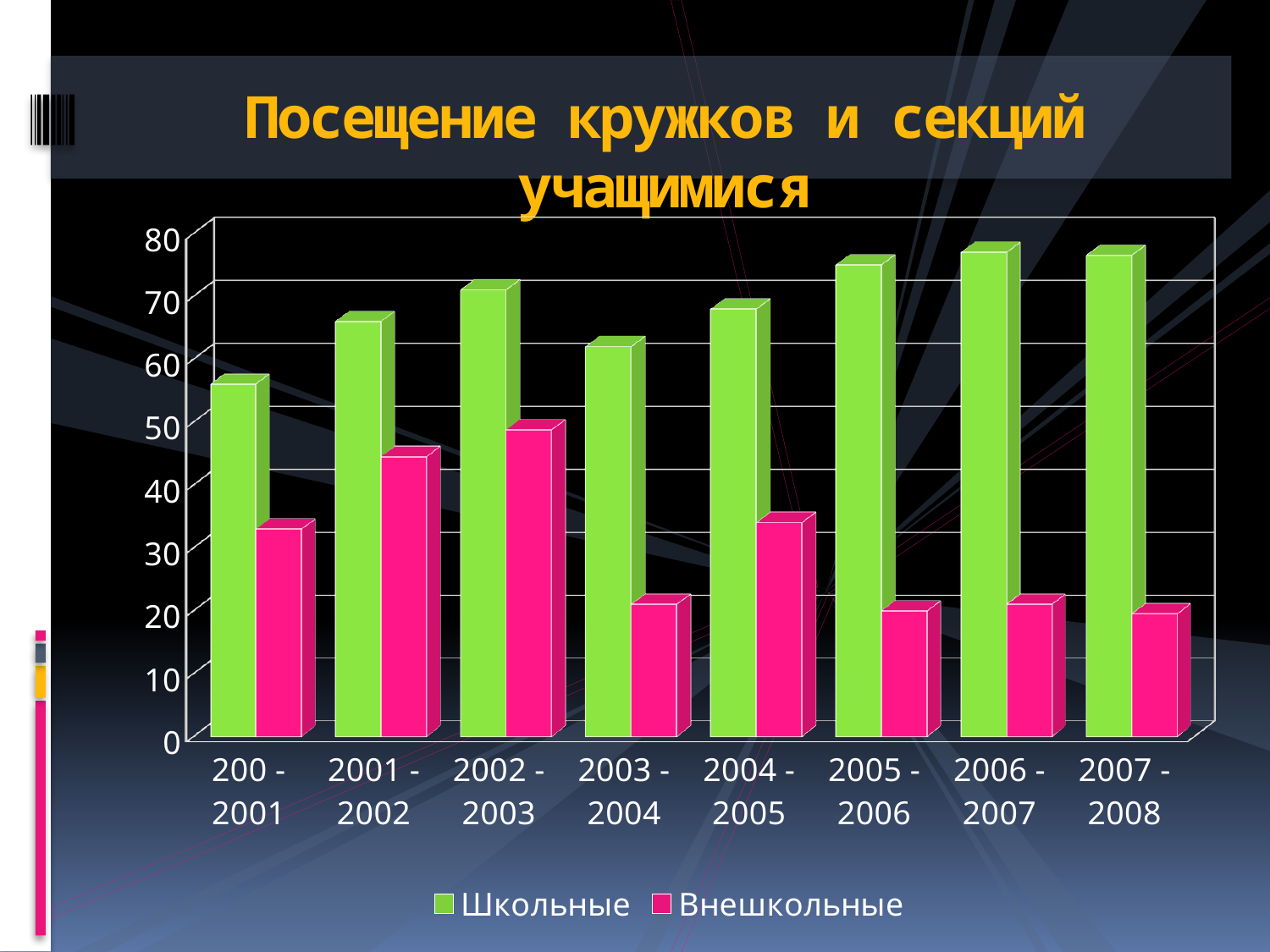
Which series is shown in green? Школьные Which is larger for 2003 - 2004: the Школьные value or the Внешкольные value? Школьные What is the title of the chart? Посещение кружков и секций учащимися What kind of chart is shown on the slide? bar chart How many series does the legend list? 2 How many school-year categories are shown on the x axis? 8 Is the Внешкольные value for 2003 - 2004 greater or less than 30? less Is the Школьные value for 2002 - 2003 greater or less than 60? greater Is the Школьные value for 2005 - 2006 greater or less than 70? greater In which school year is the Школьные value lowest? 200 - 2001 In which school year is the Внешкольные value highest? 2002 - 2003